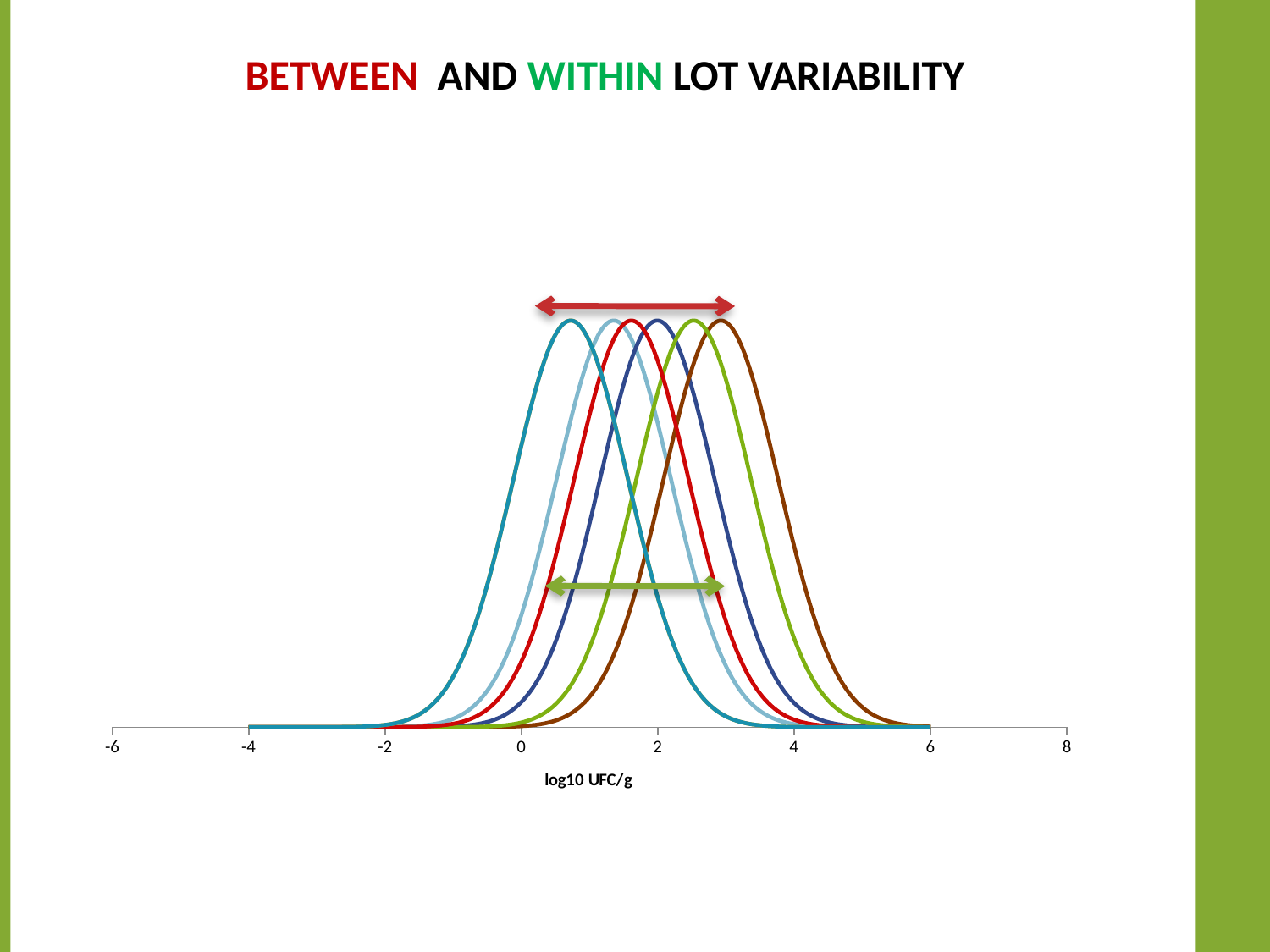
Is the peak of the teal curve at an x value greater or less than 2? less Is the peak of the light blue curve at an x value greater or less than 2? less What is the title of the slide above the chart? BETWEEN AND WITHIN LOT VARIABILITY Is the peak of the green curve at an x value greater or less than 2? greater Which curve has its peak furthest to the left along the x axis? The teal curve Which curve has its peak furthest to the right along the x axis? The brown curve What is the label on the x axis of the chart? log10 UFC/g How many bell-shaped curves are plotted on the chart? 6 What kind of chart is shown on the slide? Line chart Which curve peaks further to the right, the red curve or the brown curve? The brown curve Which curve peaks further to the left, the teal curve or the green curve? The teal curve